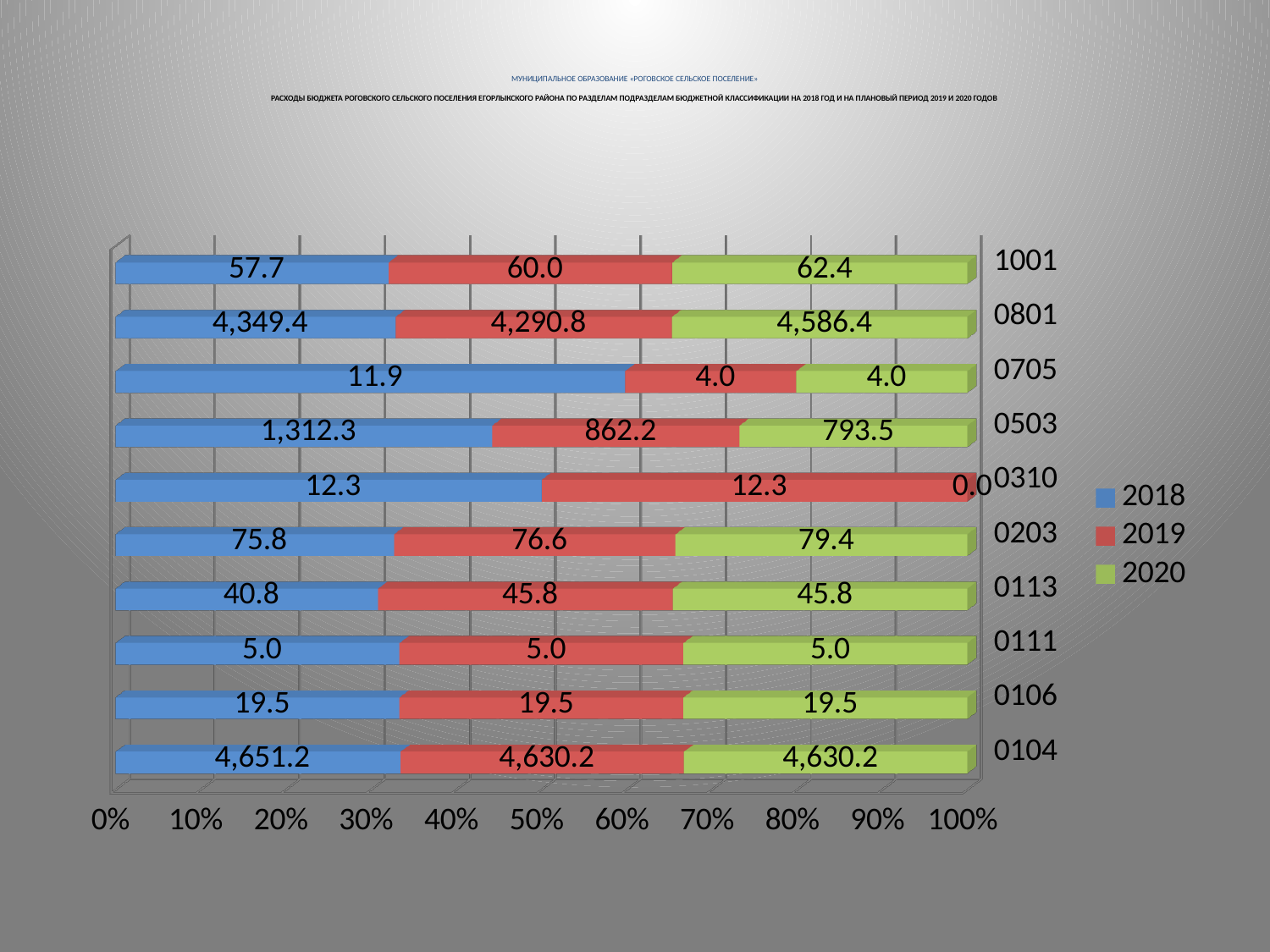
What is the 2019 value for category 0705? 4.0 What kind of chart is shown on the slide? Stacked bar chart How many series does the legend list? 3 What is the 2018 value for category 0801? 4,349.4 Which category has the lowest 2018 value? 0111 What is the 2020 value for category 0503? 793.5 What is the 2020 value for category 0310? 0.0 Which is larger: the 2018 value for 0104 or the 2018 value for 0801? 2018 value for 0104 What is the difference between the 2018 and 2019 values for category 0503? 450.1 What is the total of the three values for category 0111? 15.0 How many categories are shown on the chart? 10 Which category has the highest 2018 value? 0104